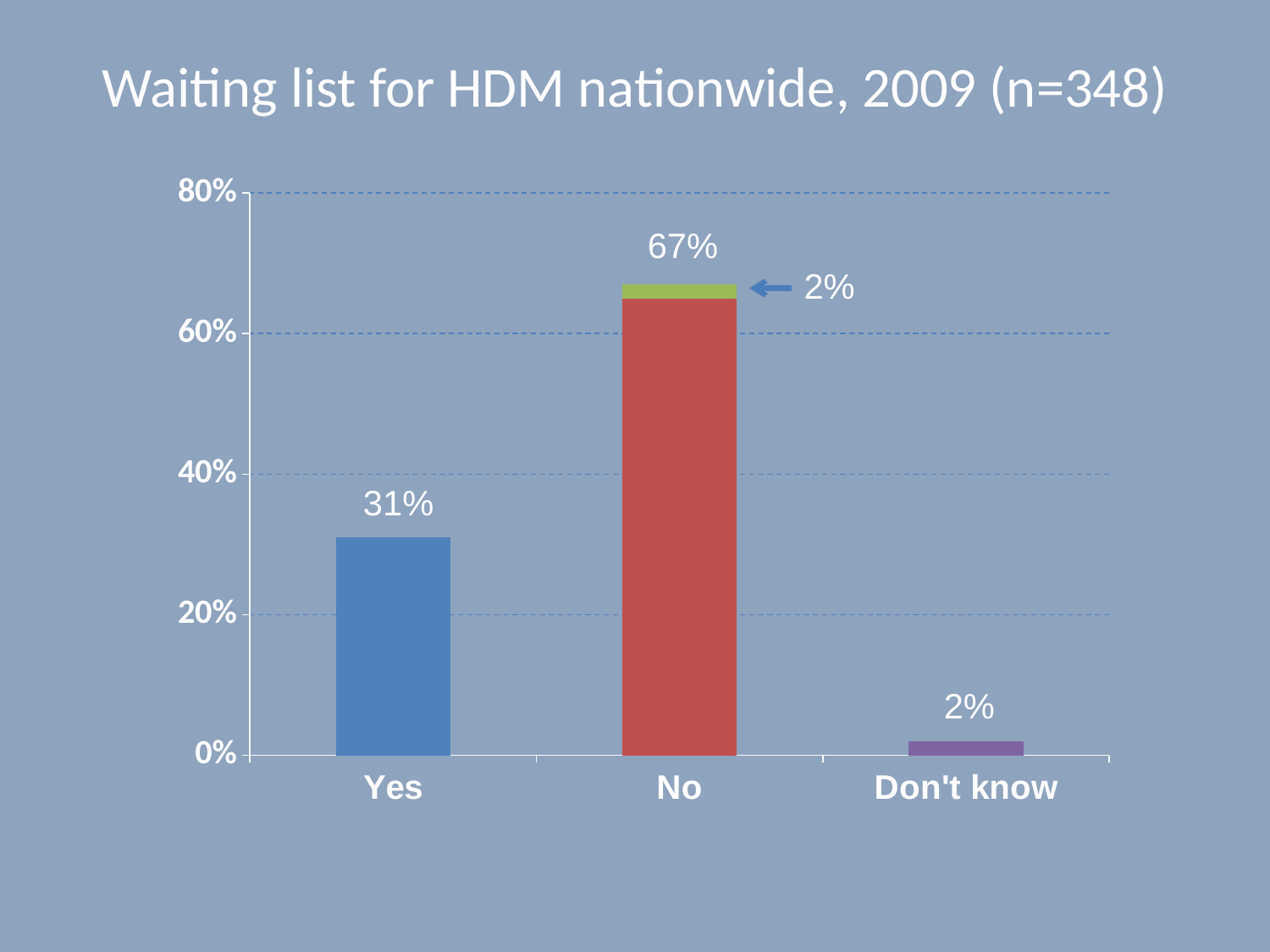
Which category has the highest value? No What value is indicated by the arrow pointing to the green segment at the top of the No bar? 2% What is the value for Don't know? 2% Which category has the lowest value? Don't know What is the difference between the values for No and Yes? 36% What is the value for No? 67% Which is larger, the value for Yes or the value for No? No How many categories are shown on the x axis? 3 What is the value for Yes? 31% What kind of chart is shown on the slide? bar chart What is the difference between the values for Yes and Don't know? 29% Is the value for Yes greater or less than 40%? less